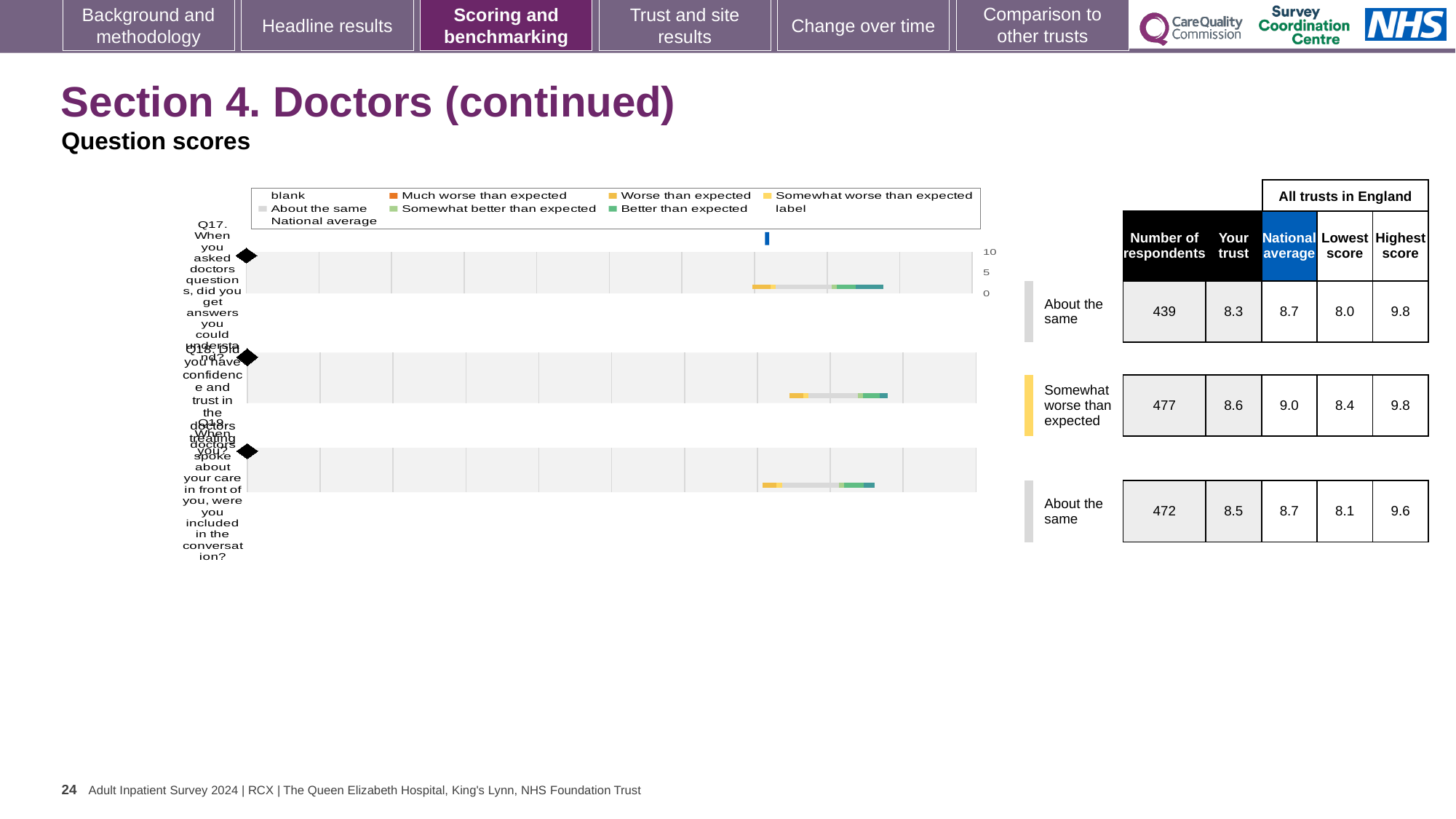
According to the table beside the chart, how many respondents answered Q19? 472 Which question has the highest 'Your trust' score in the table beside the chart? Q18 What benchmark category is shown for Q18 next to the chart? Somewhat worse than expected According to the table beside the chart, what is the national average for Q18? 9.0 According to the table beside the chart, what is the 'Your trust' score for Q17? 8.3 What is the highest tick value shown on the chart's score axis? 10 According to the table beside the chart, what is the highest score among all trusts in England for Q19? 9.6 Which question has the lowest 'Your trust' score in the table beside the chart? Q17 How many questions (categories) are plotted in the chart? 3 For Q18, what is the difference between the national average and the 'Your trust' score? 0.4 What kind of chart is used to show the question scores on this slide? Bar chart For Q17, which is larger: the 'Your trust' score or the national average? National average